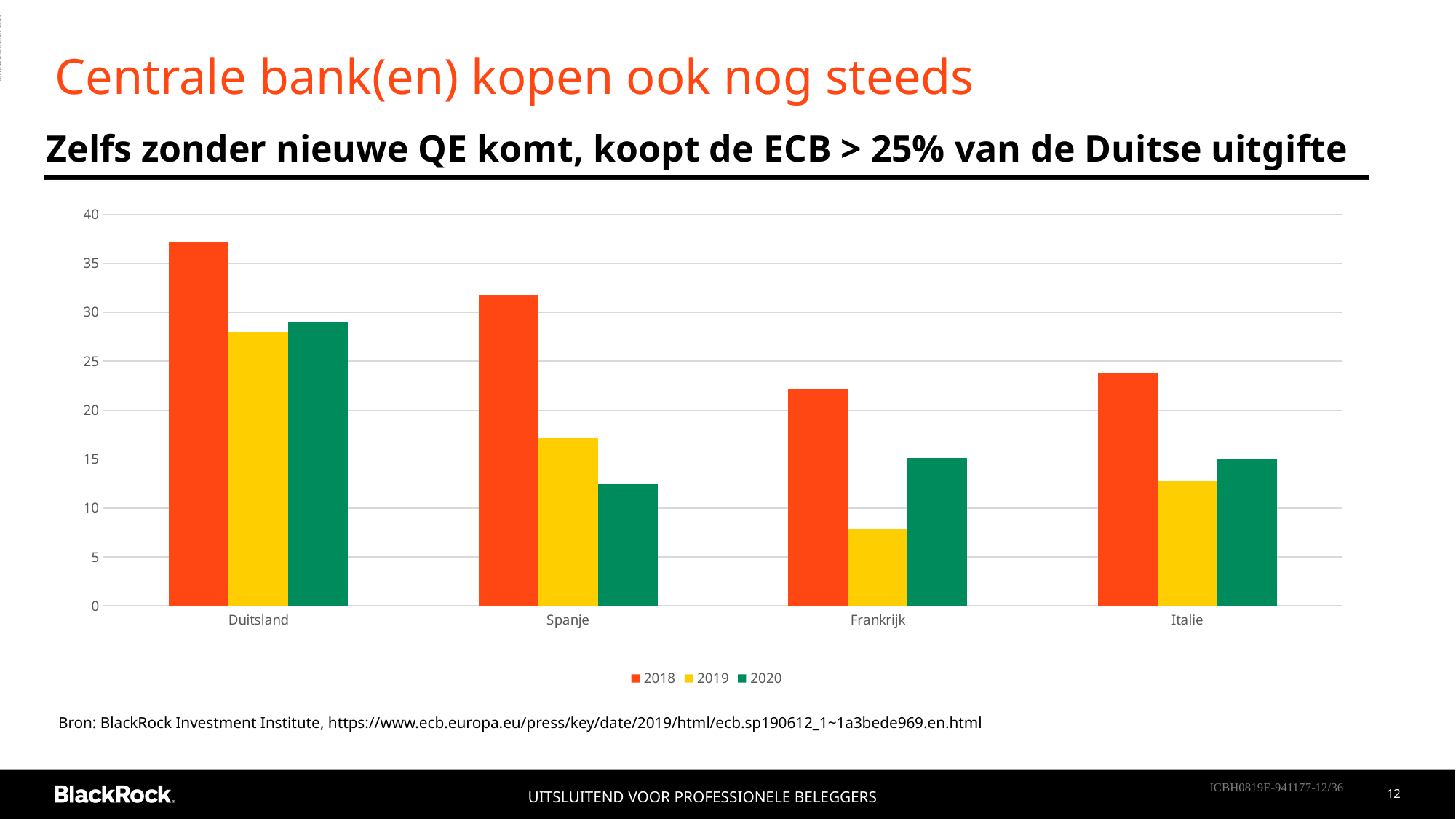
Is the 2019 value for Frankrijk greater or less than 10? less Which country has the lowest value for 2019? Frankrijk How many series does the legend list? 3 Is the 2020 value for Spanje greater or less than 10? greater For Spanje, do the values rise or fall from 2018 to 2020? fall Which colour represents the 2020 series in the legend? green Which country has the lowest value for 2020? Spanje Which country has the highest value for 2018? Duitsland What kind of chart is shown on the slide? bar chart Which is larger: the 2018 value for Spanje or the 2018 value for Italie? Spanje Is the 2018 value for Duitsland greater or less than 35? greater How many countries are shown on the x axis of the chart? 4